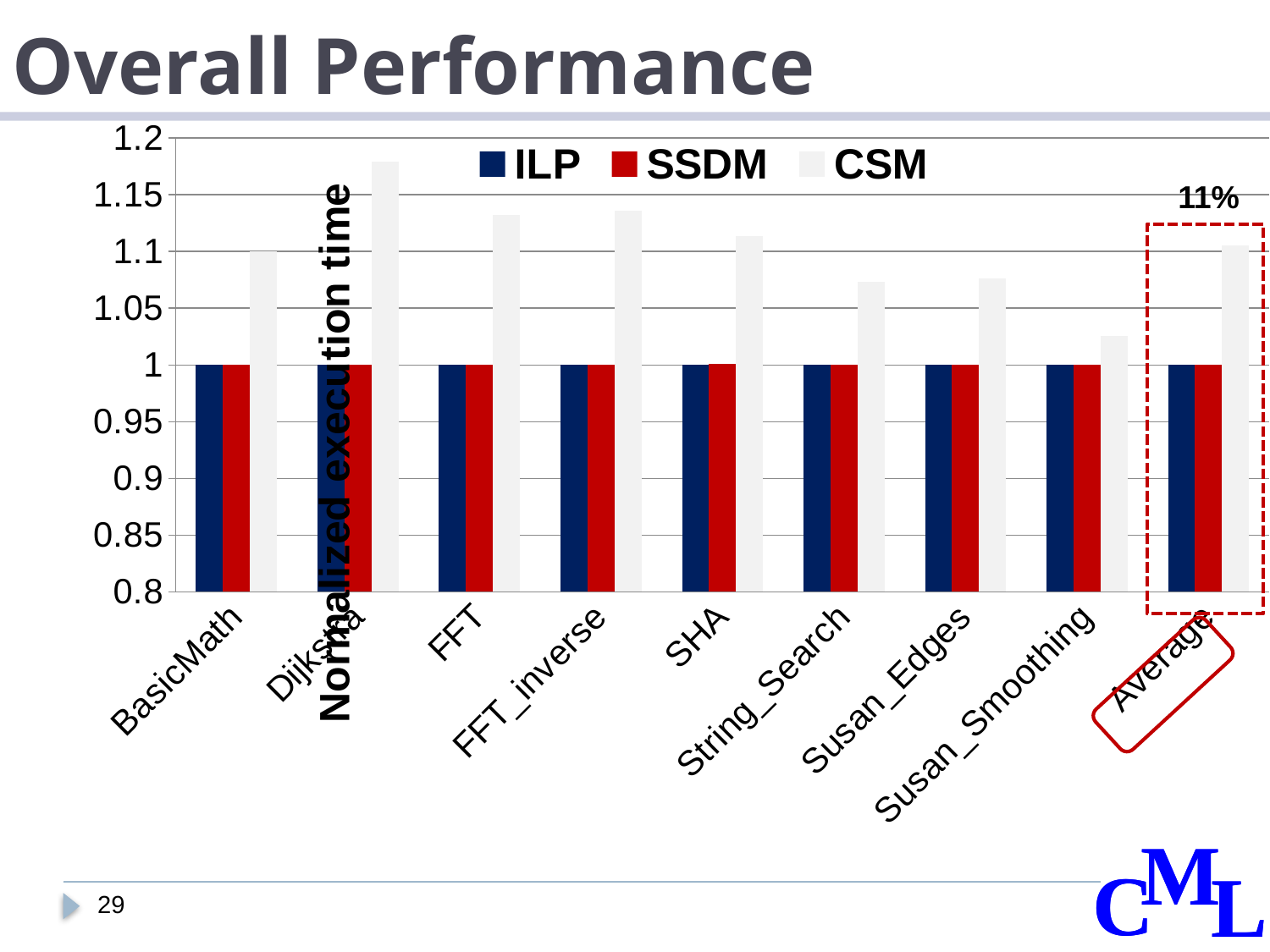
Is the CSM value for Dijkstra greater or less than 1.15? greater Is the CSM value for FFT greater or less than 1.1? greater What kind of chart is shown on the slide? bar chart What is the label on the y axis? Normalized execution time What is the ILP value for BasicMath? 1 Is the CSM value for Susan_Smoothing greater or less than 1.05? less Which category has the highest CSM value? Dijkstra How many categories are shown on the x axis? 9 For Dijkstra, which is larger: the CSM value or the ILP value? CSM Which category has the lowest CSM value? Susan_Smoothing How many series does the legend list? 3